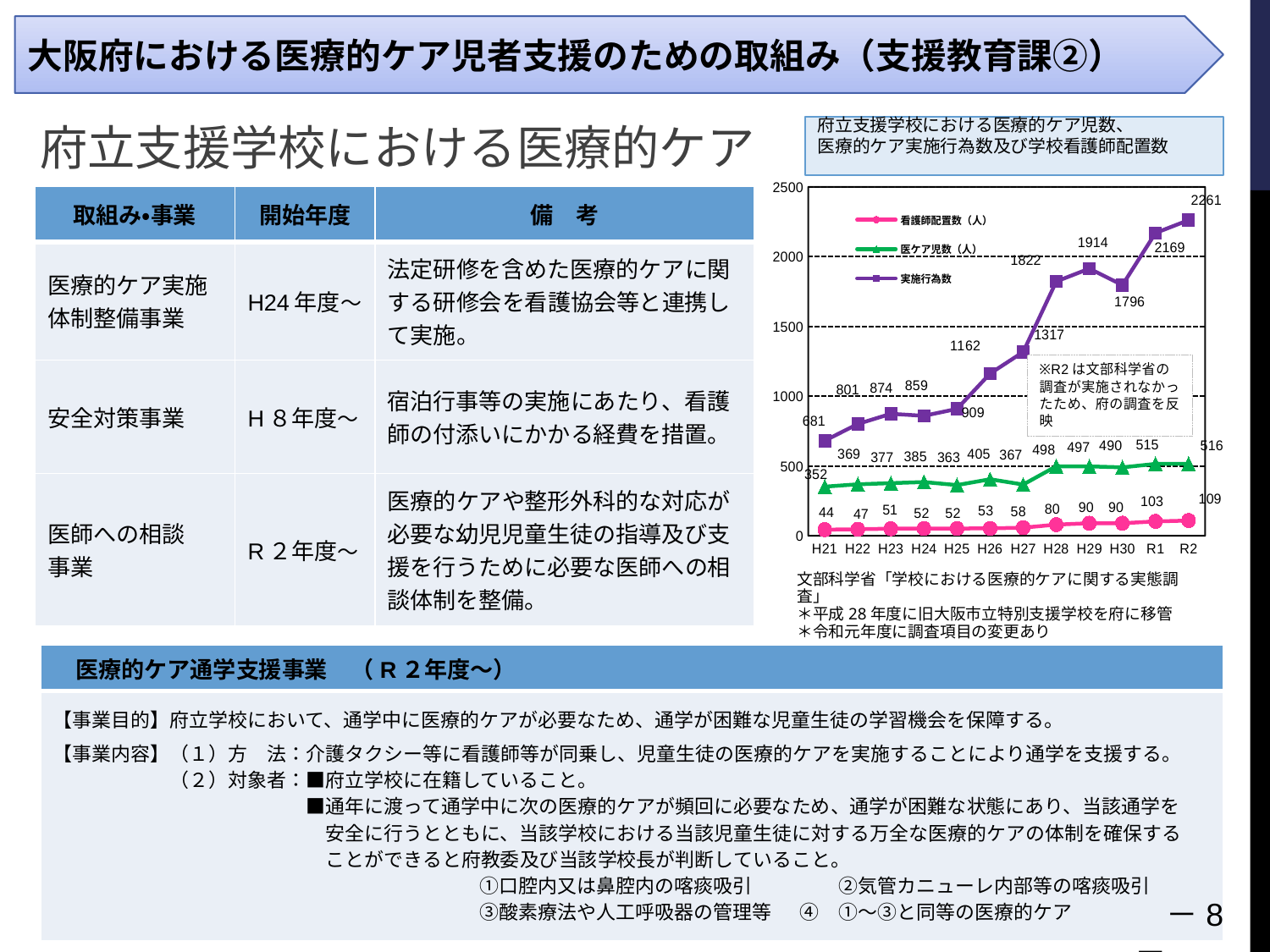
How many series does the chart legend list? 3 Does 看護師配置数（人） generally rise or fall from H21 to R2? rise In which year is 実施行為数 highest? R2 What is the value of 医ケア児数（人） for H28? 498 What kind of chart is shown on the slide? line chart What is the difference between 実施行為数 in R2 and in H21? 1580 How many years (points) are shown on the x axis of the chart? 12 What is the title of the chart? 府立支援学校における医療的ケア児数、医療的ケア実施行為数及び学校看護師配置数 Which is larger, 実施行為数 in H29 or in H30? H29 What is the value of 看護師配置数（人） for H21? 44 In which year is 看護師配置数（人） lowest? H21 What is the value of 実施行為数 for R2? 2261